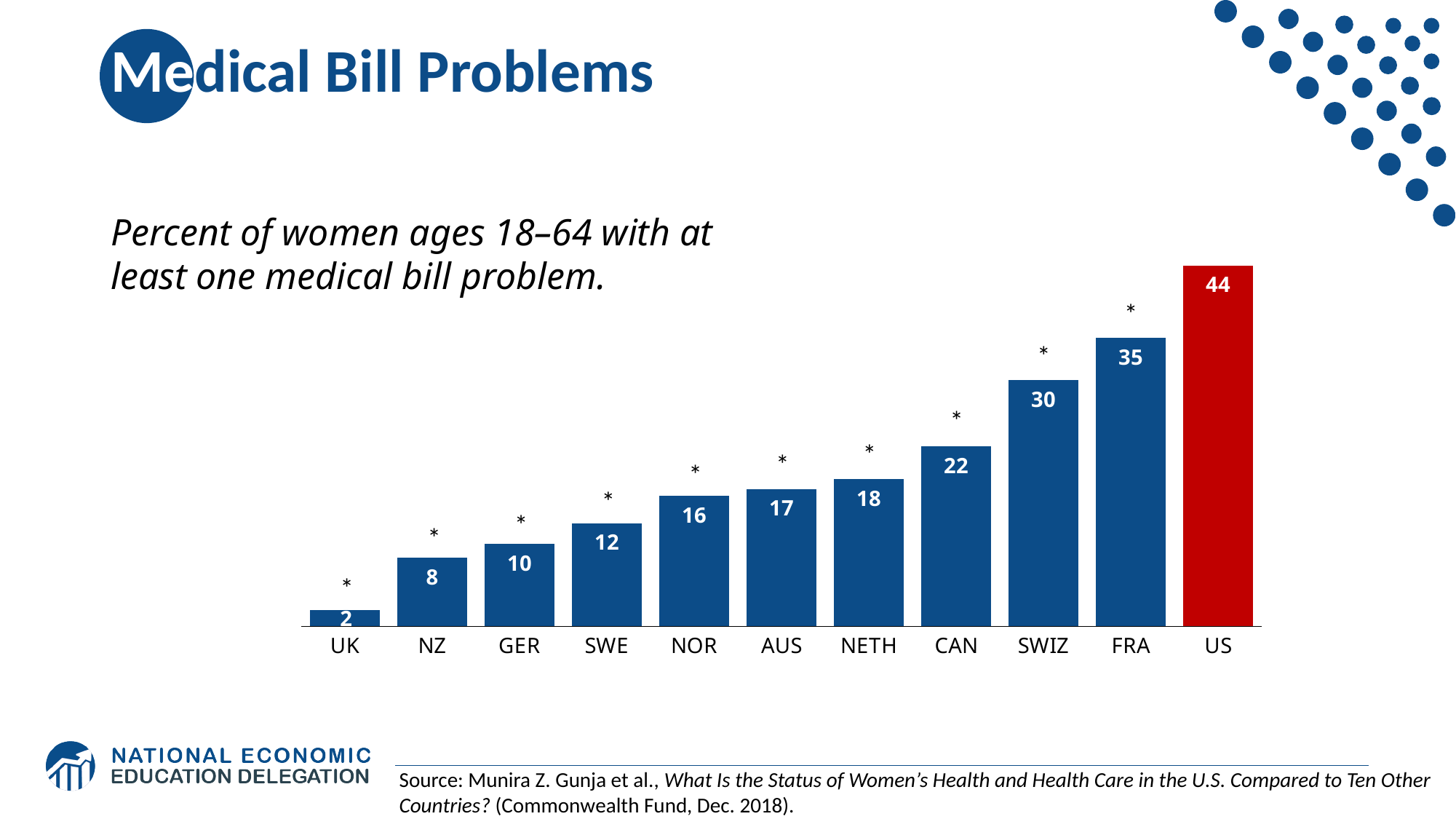
What is the value for SWE? 12 Which country has the highest value? US Which country has the lowest value? UK Which bar is coloured red rather than blue? US What is the difference between the values for the US and FRA? 9 What is the value for CAN? 22 What is the difference between the values for SWIZ and NZ? 22 What is the value for the US? 44 How many countries are shown on the chart? 11 What kind of chart is this? Bar chart Which has a larger value, NOR or NETH? NETH Do the values rise or fall from left to right along the x axis? Rise